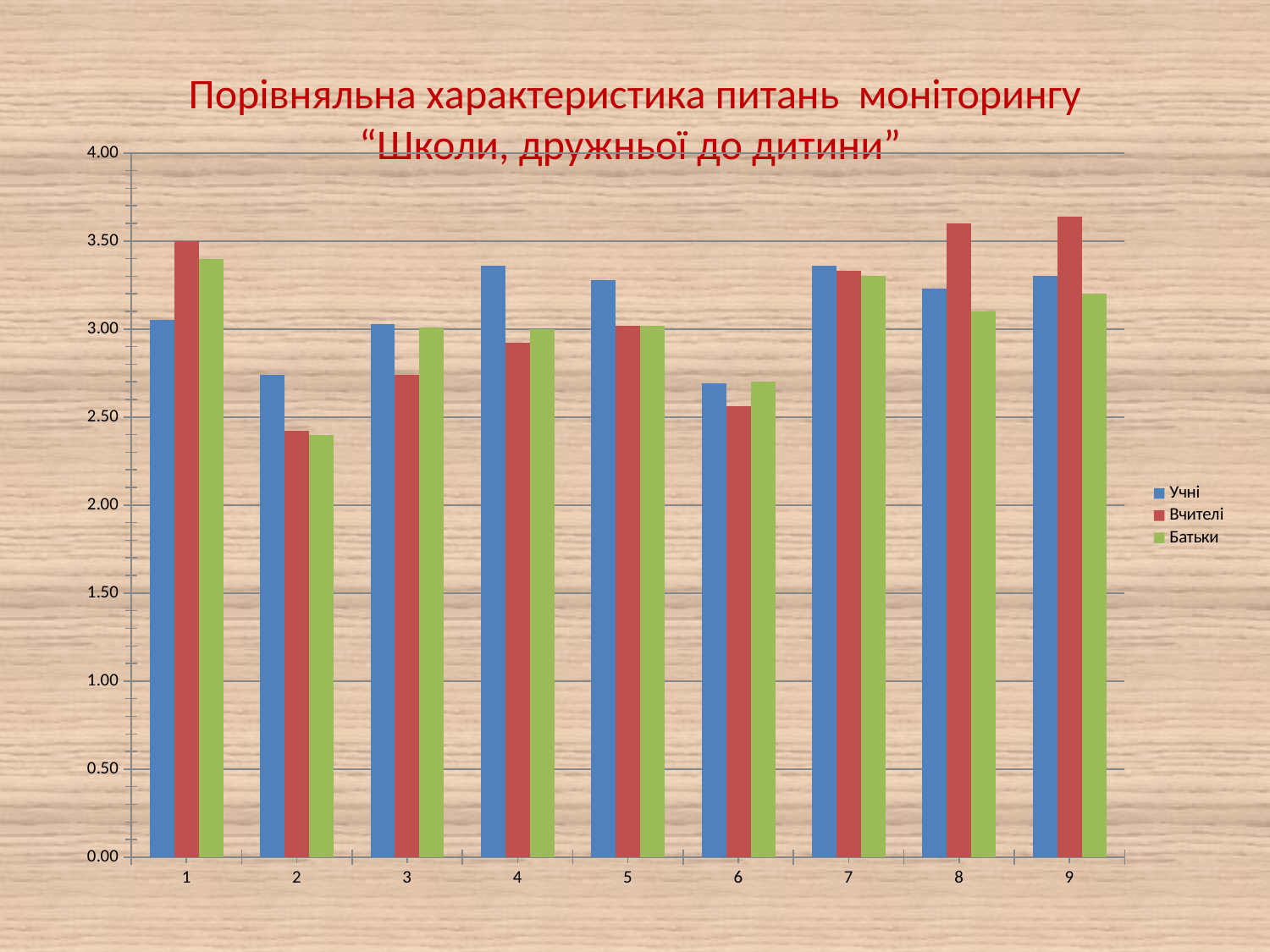
How many series does the legend list? 3 In which category is the value for Вчителі the lowest? 2 In category 2, which is larger: the value for Учні or the value for Вчителі? Учні What kind of chart is shown on the slide? bar chart In category 1, which is larger: the value for Учні or the value for Вчителі? Вчителі How many categories are shown along the x axis? 9 Is the value for Учні in category 4 greater or less than 3.00? greater In which category is the value for Батьки the lowest? 2 Is the value for Батьки in category 6 greater or less than 3.00? less Is the value for Вчителі in category 2 greater or less than 2.50? less What are the three series named in the legend? Учні, Вчителі, Батьки